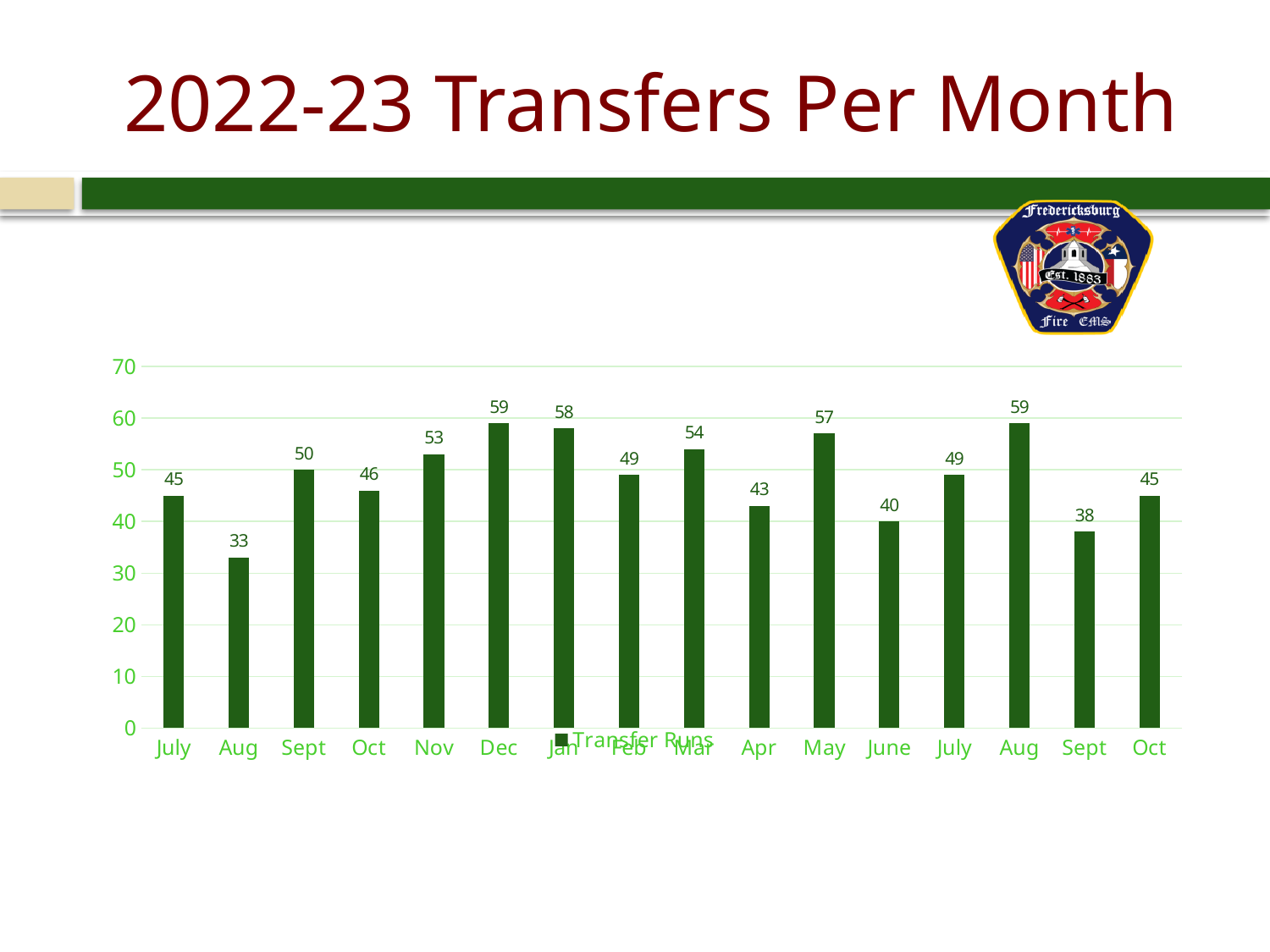
What is the difference between the values for May and June? 17 How many series does the legend list? 1 What is the value for Mar? 54 How many bars are plotted in the chart? 16 What is the value for Dec? 59 What is the value for the last Sept bar on the right? 38 What is the difference between the values for Dec and Jan? 1 What kind of chart is shown on the slide? bar chart What is the value for the first Aug bar on the left? 33 Which is larger, the value for Nov or the value for Oct (the first Oct)? Nov Which month has the lowest value? Aug (the first one) Is the value for Apr greater or less than 50? less